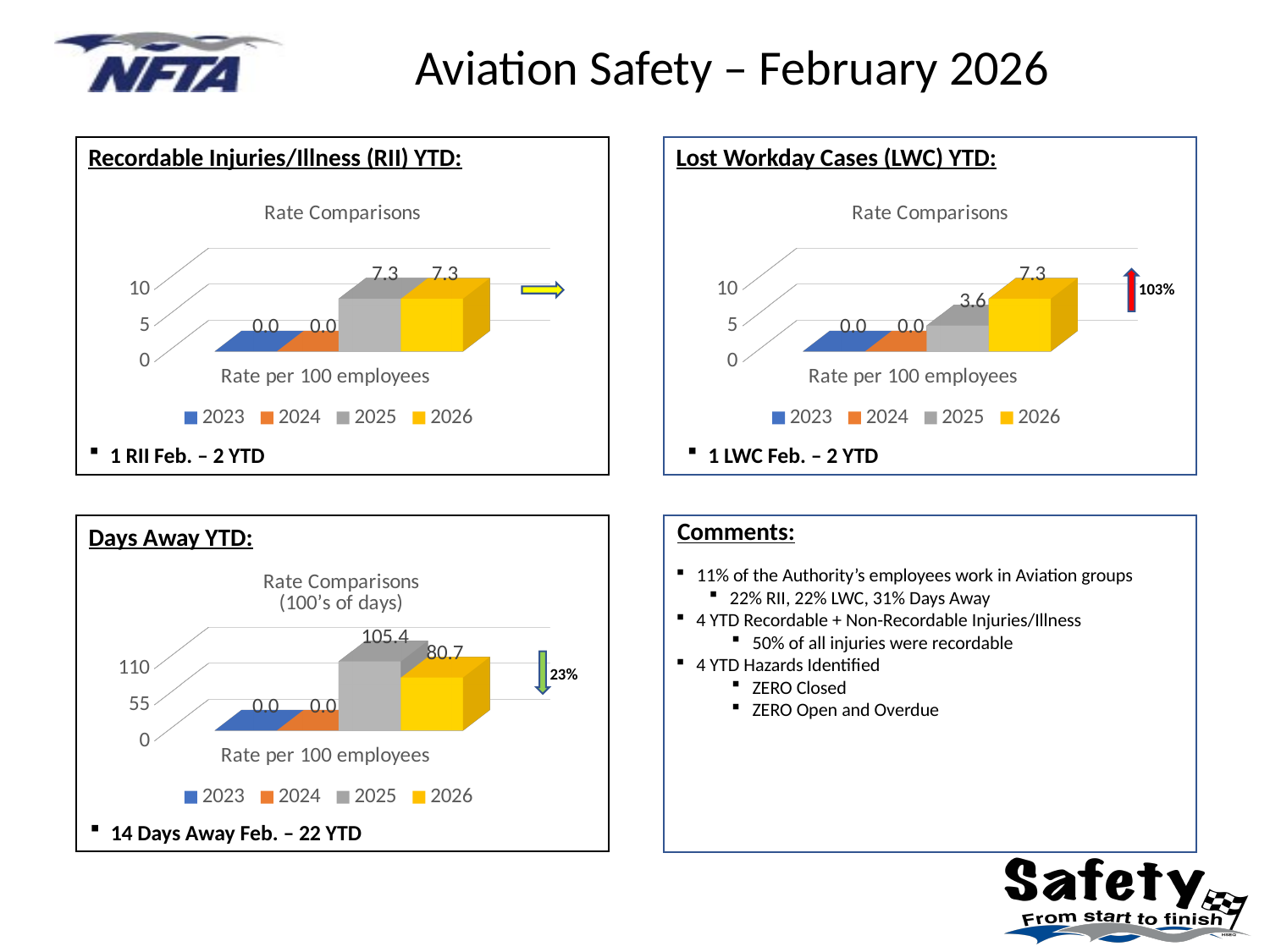
In the Days Away YTD chart, is the value for 2025 larger or smaller than the value for 2026? larger In the Lost Workday Cases (LWC) YTD chart, which year has the highest value? 2026 What is the x-axis category label in the Days Away YTD chart? Rate per 100 employees What kind of chart is the Lost Workday Cases (LWC) YTD chart? bar chart In the Days Away YTD chart, what is the value for 2025? 105.4 In the Recordable Injuries/Illness (RII) YTD chart, what is the value for 2026? 7.3 In the Days Away YTD chart, what is the value for 2026? 80.7 In the Lost Workday Cases (LWC) YTD chart, what is the value for 2025? 3.6 In the Days Away YTD chart, what is the difference between the 2025 and 2026 values? 24.7 In the Days Away YTD chart, which year has the highest value? 2025 How many series does the legend list in the Recordable Injuries/Illness (RII) YTD chart? 4 In the Lost Workday Cases (LWC) YTD chart, what is the difference between the 2026 and 2025 values? 3.7